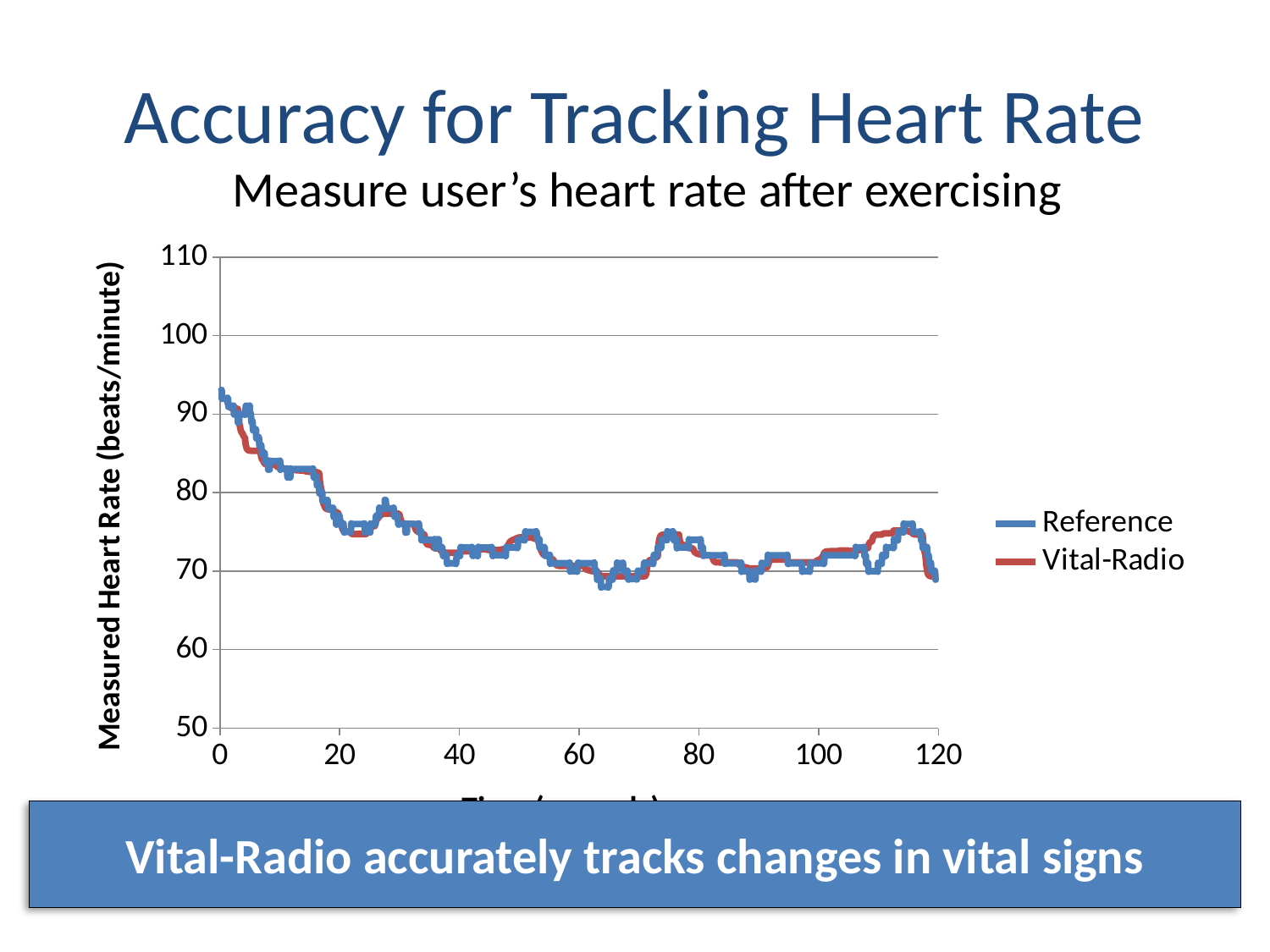
Is the Vital-Radio heart rate at time 40 greater or less than 60? greater What colour is the Vital-Radio line? red What kind of chart is shown on the slide? line chart Is the Reference heart rate at time 60 greater or less than 80? less Is the Reference heart rate at time 0 greater or less than 90? greater Overall, do the heart rate values rise or fall from the start to the end of the time axis? fall Do the heart rate values rise or fall between time 0 and time 20? fall What is the highest value shown on the y axis? 110 What are the two series named in the legend? Reference and Vital-Radio How many series does the legend list? 2